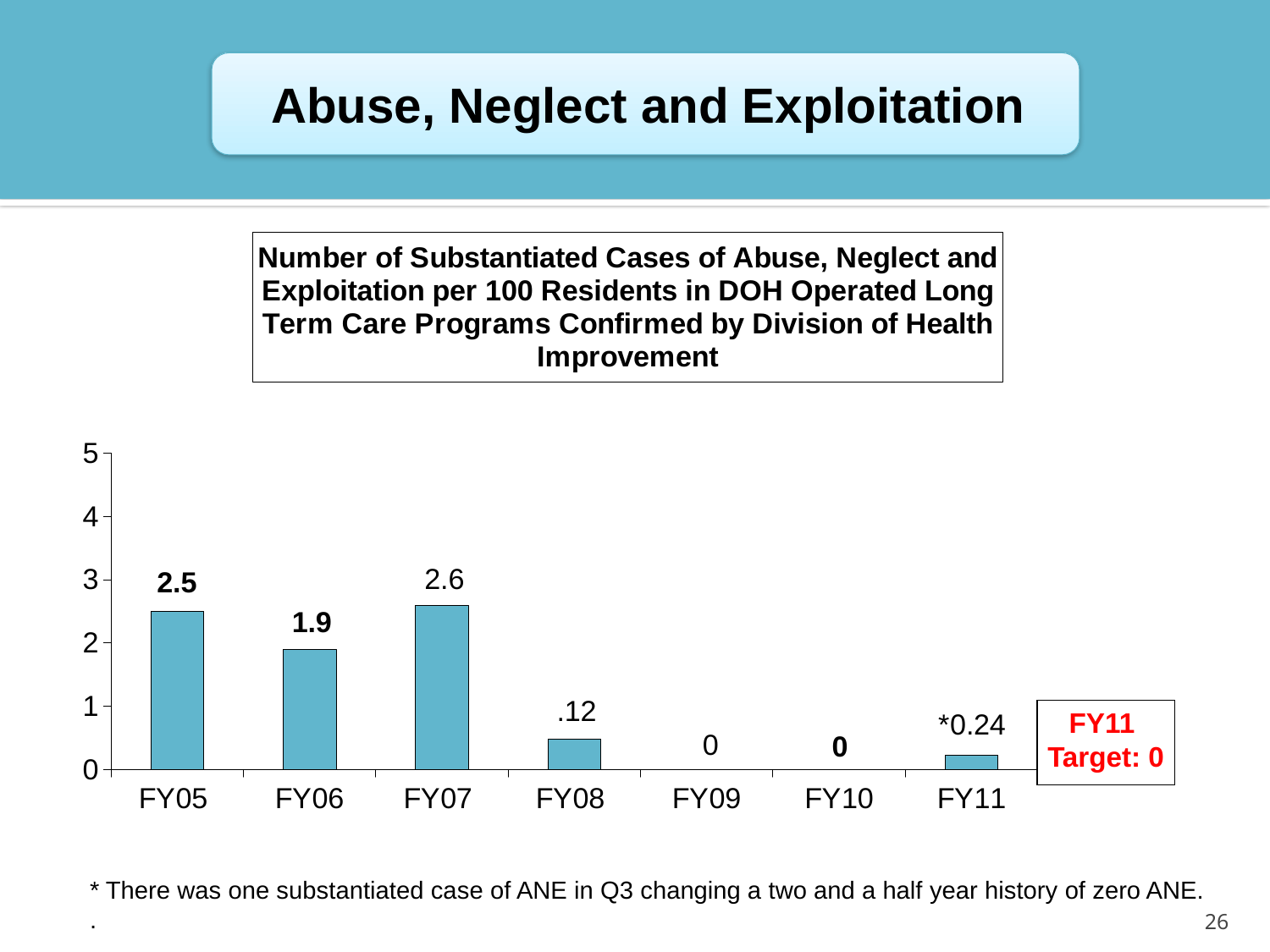
What kind of chart is shown on the slide? bar chart What is the FY11 target shown on the slide? 0 What is the value for FY05? 2.5 Is the value for FY05 greater or less than 2? greater Which fiscal year has the highest value? FY07 What is the value for FY06? 1.9 What is the value for FY08? .12 How many fiscal years are shown on the x axis? 7 What is the value for FY07? 2.6 What is the value for FY11? 0.24 Which is larger, the value for FY06 or the value for FY08? FY06 What is the difference between the values for FY05 and FY06? 0.6